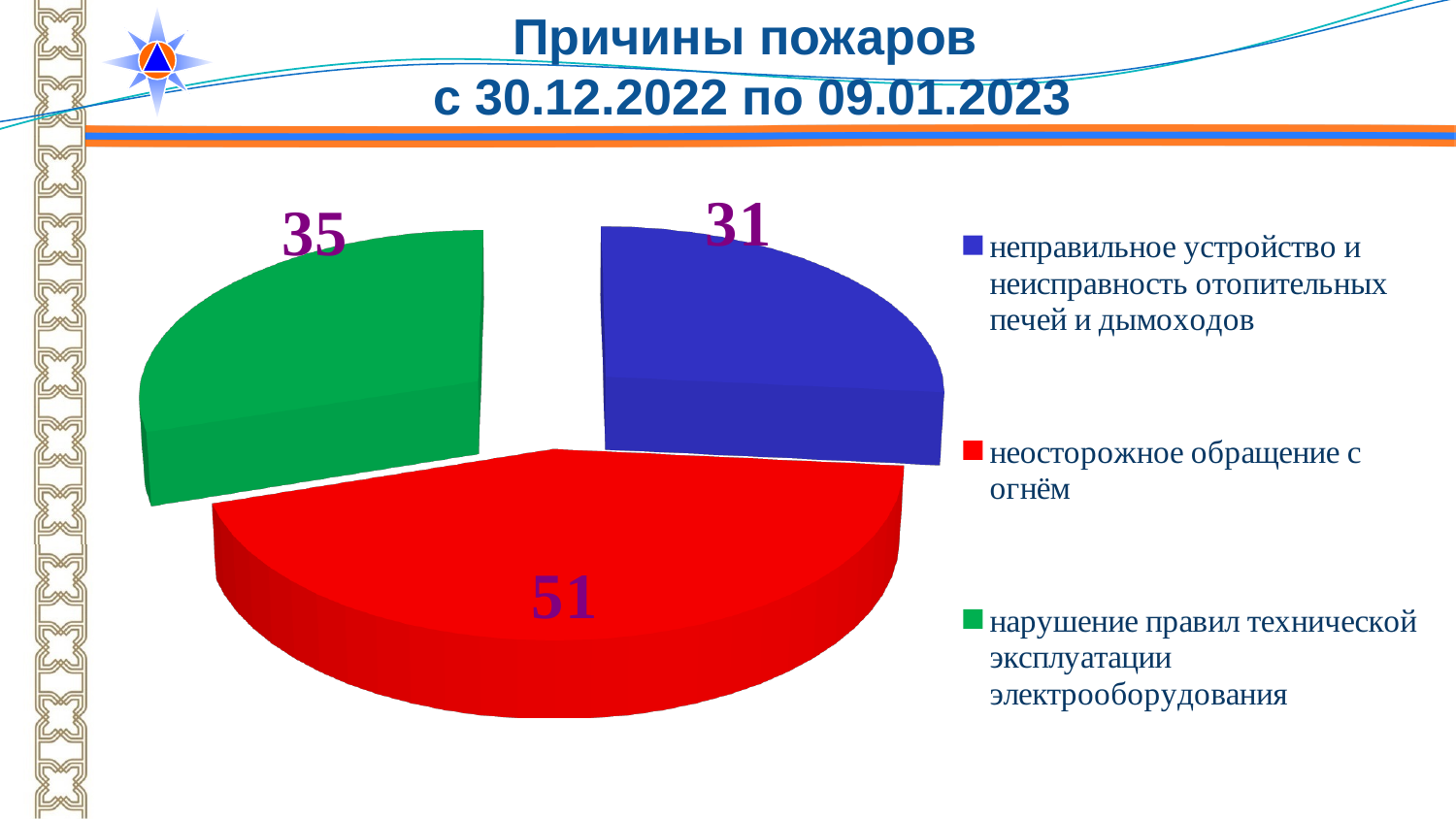
What is the value for «неосторожное обращение с огнём»? 51 What is the difference between the value for «неосторожное обращение с огнём» and the value for «нарушение правил технической эксплуатации электрооборудования»? 16 Which cause of fires has the smallest slice? неправильное устройство и неисправность отопительных печей и дымоходов Which is larger: the value for «нарушение правил технической эксплуатации электрооборудования» or the value for «неправильное устройство и неисправность отопительных печей и дымоходов»? нарушение правил технической эксплуатации электрооборудования What is the value for «неправильное устройство и неисправность отопительных печей и дымоходов»? 31 What colour is the slice for «неосторожное обращение с огнём»? red What is the title of the chart on the slide? Причины пожаров с 30.12.2022 по 09.01.2023 What kind of chart is shown on the slide? pie chart What is the value for «нарушение правил технической эксплуатации электрооборудования»? 35 How many entries does the legend list? 3 Which cause of fires has the largest slice? неосторожное обращение с огнём How many slices does the pie chart have? 3